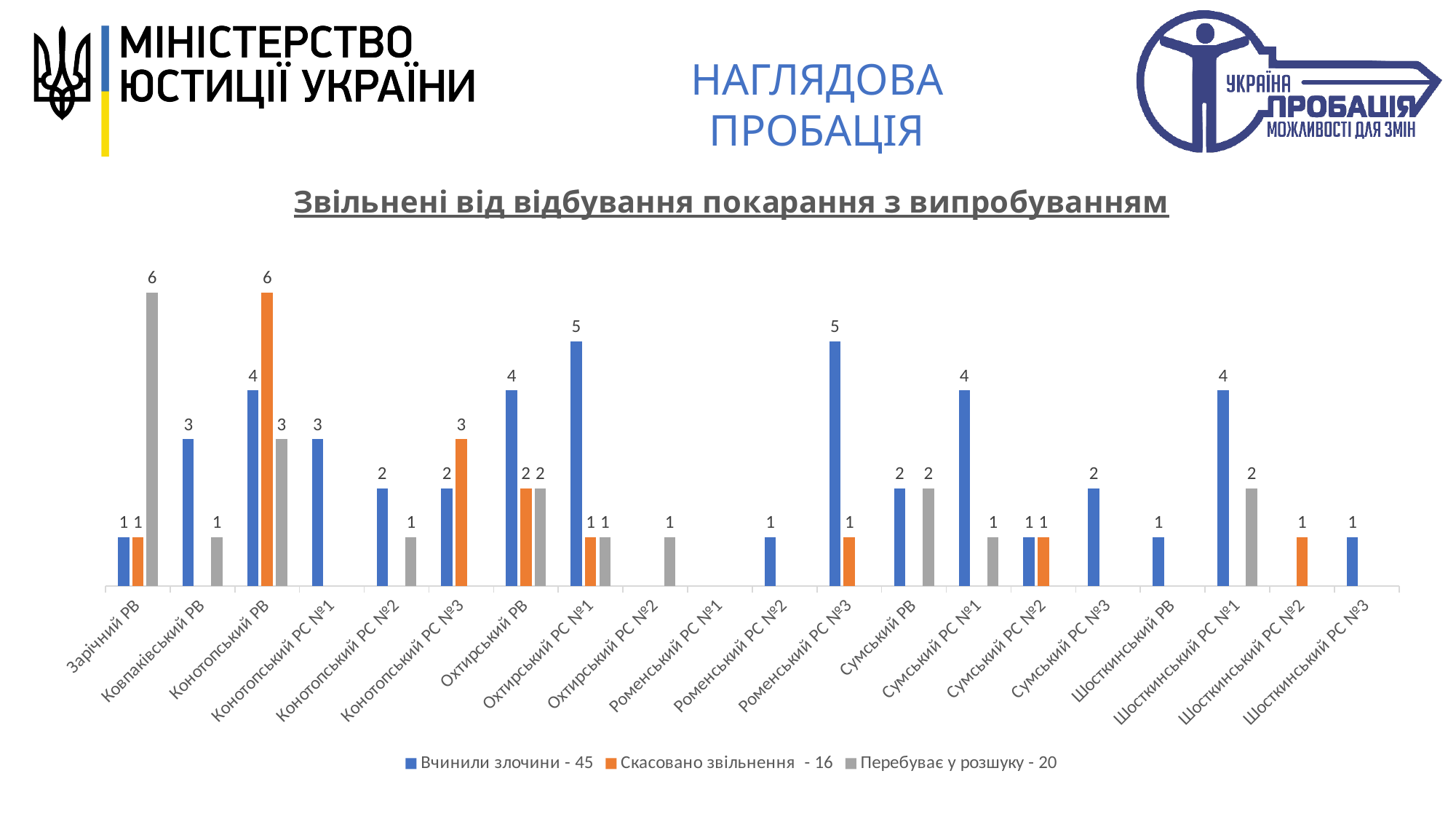
What is the value of "Вчинили злочини" for Роменський РС №3? 5 What is the value of "Скасовано звільнення" for Конотопський РВ? 6 Which category has the highest value for "Скасовано звільнення"? Конотопський РВ How many series does the legend list? 3 What is the value of "Перебуває у розшуку" for Зарічний РВ? 6 What is the total of the three series for Конотопський РВ? 13 What is the difference between the "Вчинили злочини" values for Охтирський РС №1 and Ковпаківський РВ? 2 Which category has the highest value for "Перебуває у розшуку"? Зарічний РВ Which is larger: the "Вчинили злочини" value for Сумський РС №1 or for Сумський РВ? Сумський РС №1 What total is shown in the legend for the series "Вчинили злочини"? 45 How many categories are shown on the x axis of the chart? 20 What type of chart is shown on the slide? bar chart